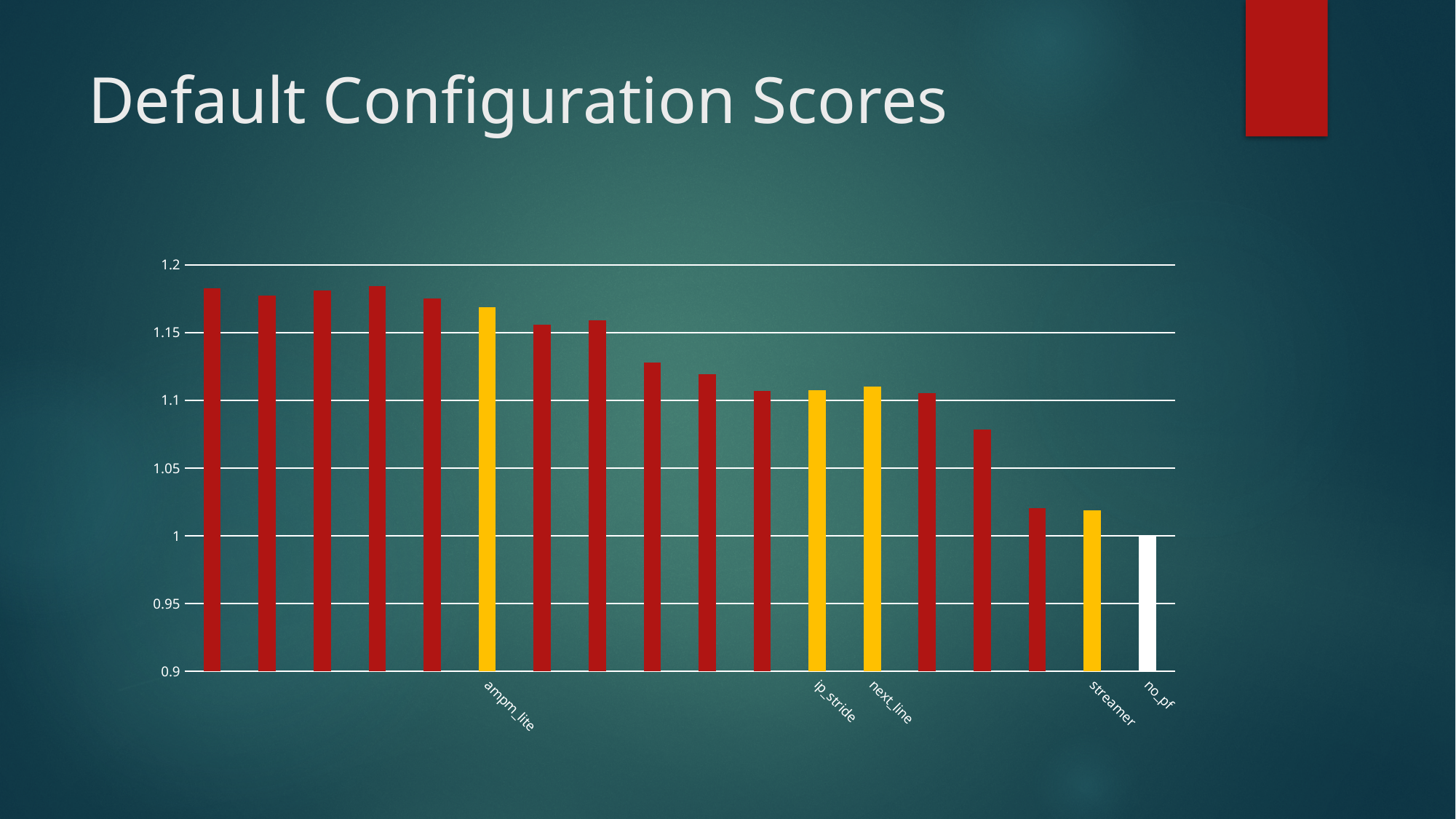
Is the value for next_line greater or less than 1.1? greater What is the value for no_pf? 1 Do the bar values generally rise or fall from left to right along the x axis? fall Which category has the lowest value in the chart? no_pf What is the title of the chart on the slide? Default Configuration Scores Is the value for ampm_lite greater or less than 1.15? greater What kind of chart is shown on the slide? bar chart Is the value for streamer greater or less than 1.05? less What colour is the bar for no_pf? white How many bars are plotted in the chart? 18 Which is larger, the value for ampm_lite or the value for streamer? ampm_lite